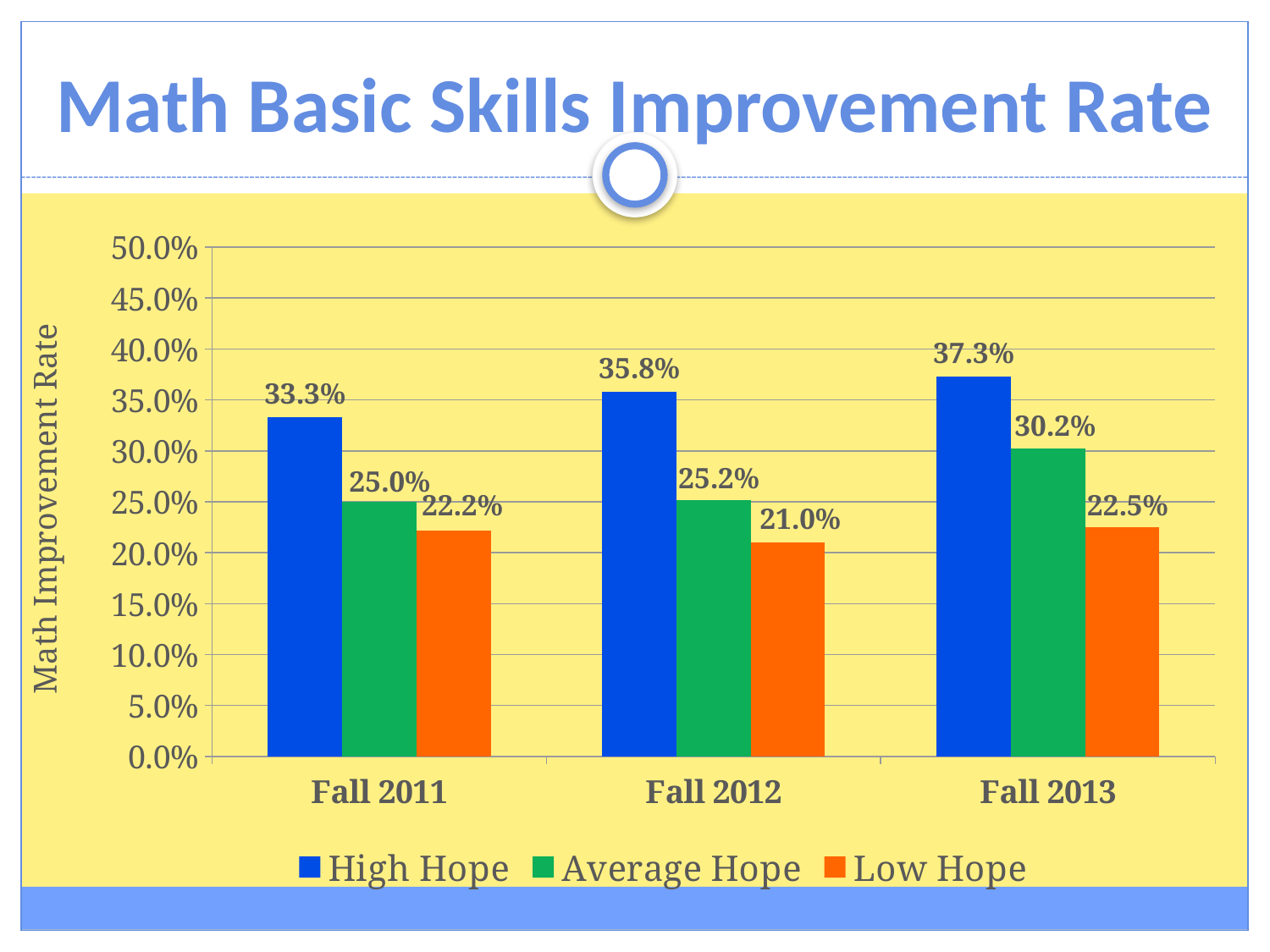
How many series does the legend list? 3 In which period is the Low Hope value lowest? Fall 2012 Does the High Hope value rise or fall from Fall 2011 to Fall 2013? rise What is the value for Average Hope in Fall 2013? 30.2% How many periods are shown on the x axis? 3 Is the value for High Hope in Fall 2012 greater or less than 30.0%? greater What is the value for High Hope in Fall 2011? 33.3% What kind of chart is shown on the slide? bar chart In which period is the High Hope value highest? Fall 2013 What is the value for Low Hope in Fall 2012? 21.0% Which is larger in Fall 2012: the Average Hope value or the Low Hope value? Average Hope What is the difference between the High Hope and Low Hope values in Fall 2013? 14.8%